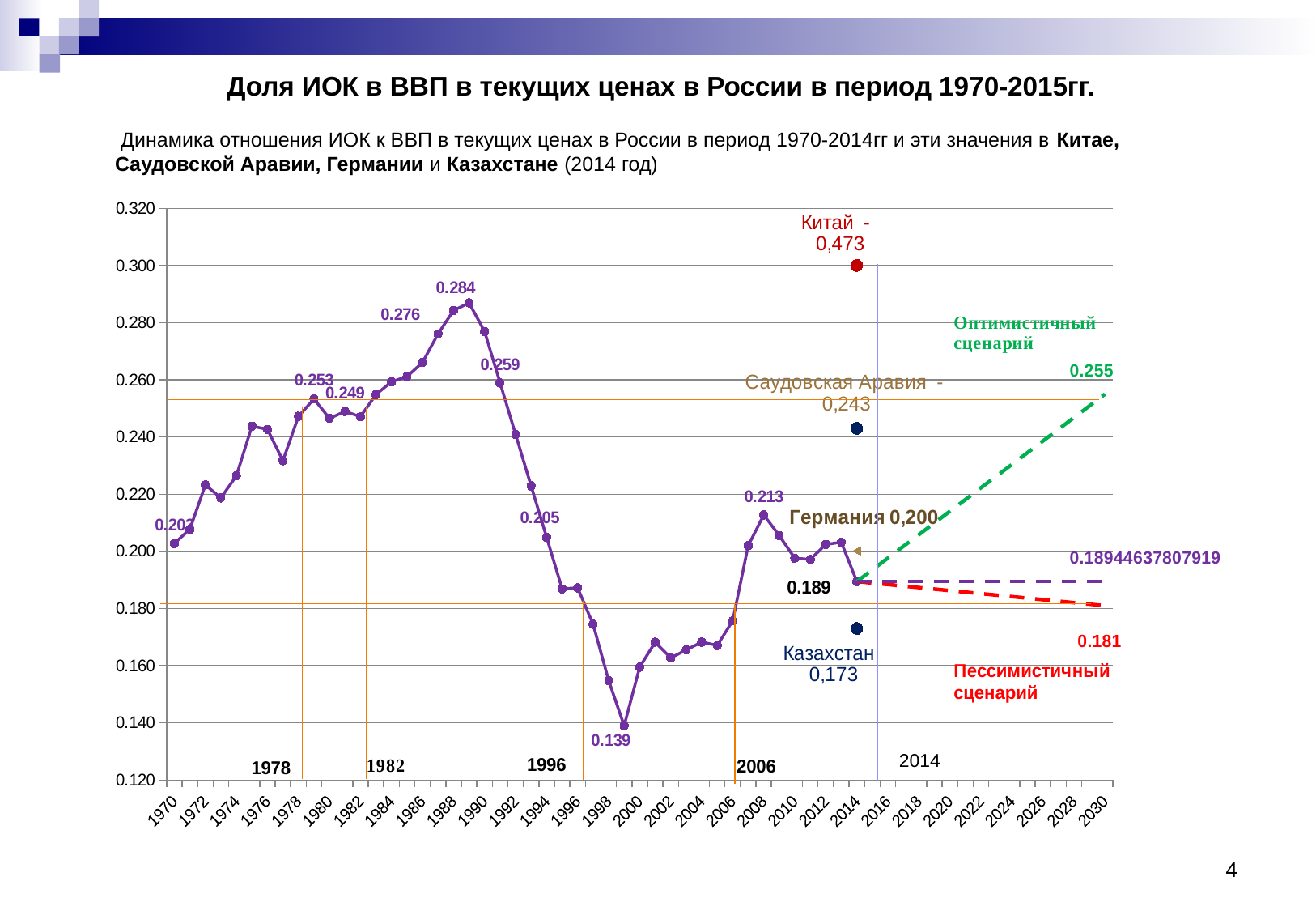
Which has the larger value, Китай or Саудовская Аравия? Китай What is the lowest value labeled on the Russian series? 0.139 Do the values for Russia rise or fall between 1989 and 1999? fall What value is shown for Китай (China)? 0,473 What value does the optimistic scenario (Оптимистичный сценарий) reach by 2030? 0.255 What is the highest value labeled on the Russian series? 0.284 What is the value for Russia in 2014? 0.189 What is the difference between the optimistic scenario value (0.255) and the pessimistic scenario value (0.181) in 2030? 0.074 What kind of chart is shown on the slide? line chart What value is shown for Казахстан (Kazakhstan)? 0,173 What value is shown for Саудовская Аравия (Saudi Arabia)? 0,243 What value does the pessimistic scenario (Пессимистичный сценарий) reach by 2030? 0.181